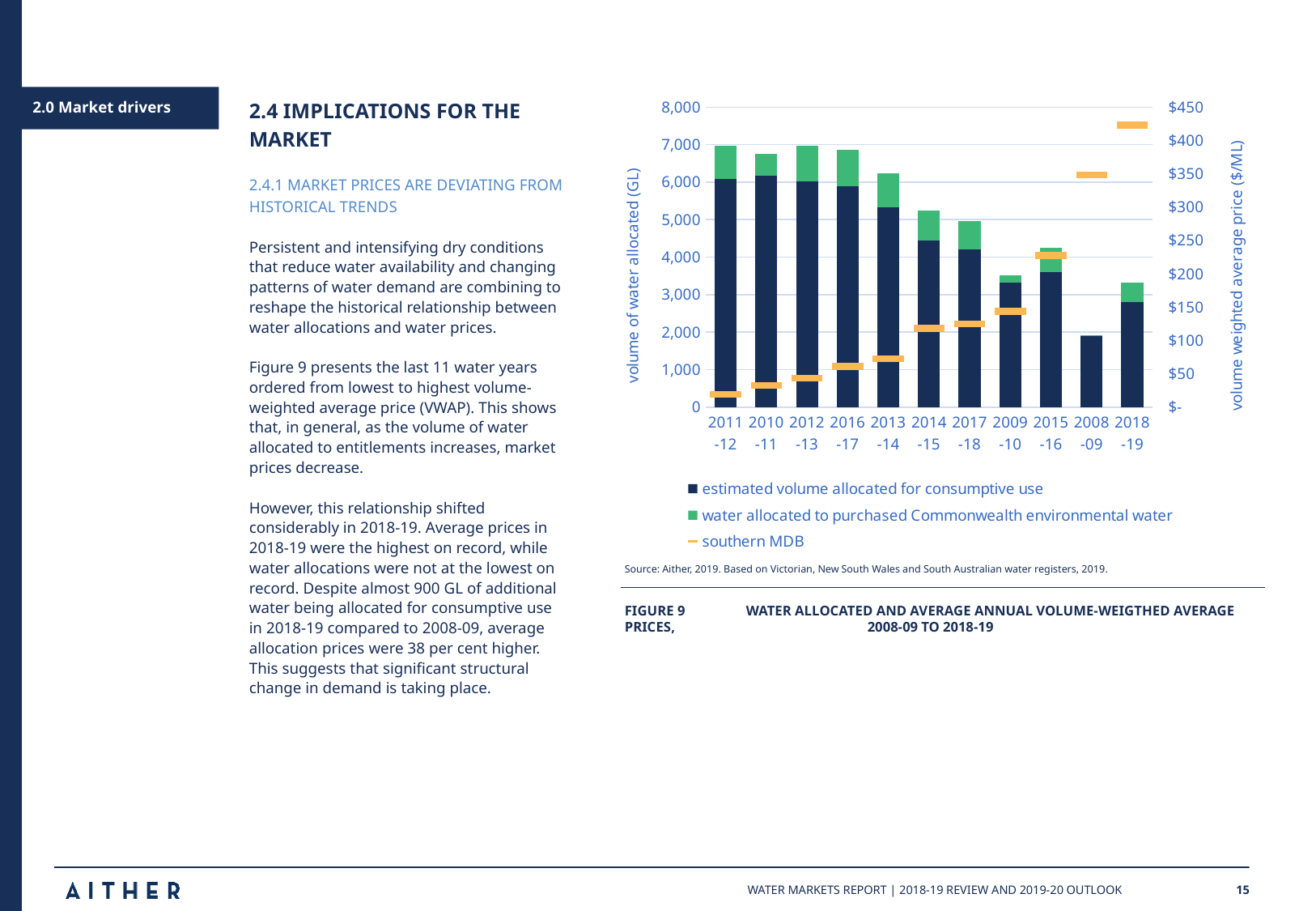
Which has the larger total volume of water allocated, 2014-15 or 2009-10? 2014-15 How many water years are shown along the x axis? 11 Which water year has the highest southern MDB volume weighted average price? 2018-19 How many series does the legend list? 3 Is the southern MDB price for 2015-16 greater or less than $200? greater Which water year has the lowest southern MDB volume weighted average price? 2011-12 Is the southern MDB price for 2018-19 greater or less than $400? greater Which water year has the lowest total volume of water allocated? 2008-09 What kind of chart is shown on the slide? combination bar and line chart Does the southern MDB volume weighted average price rise or fall moving left to right along the x axis? rise What is the label of the right-hand vertical axis? volume weighted average price ($/ML)